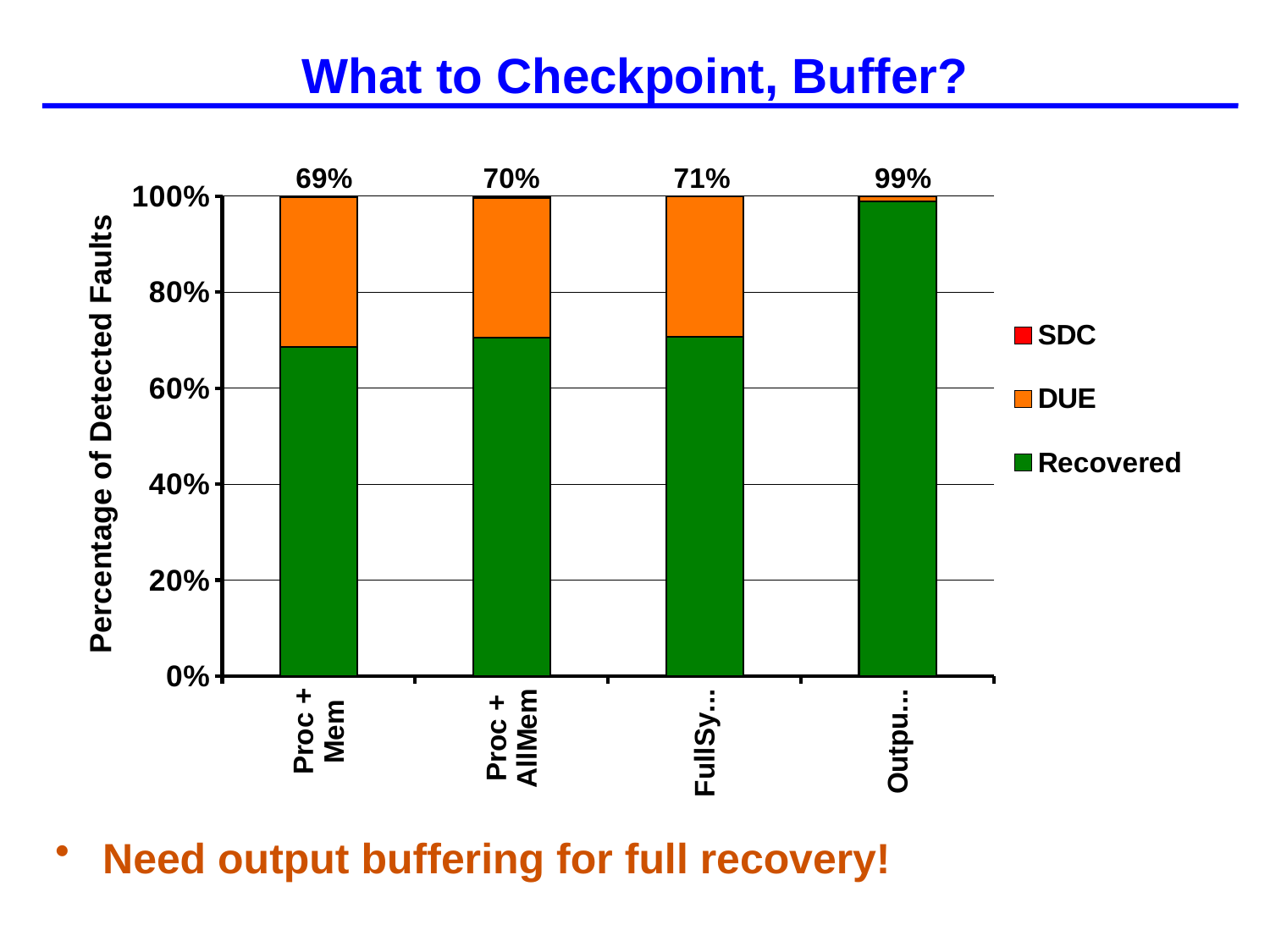
Which has the larger labelled value, Proc + Mem or Proc + AllMem? Proc + AllMem Do the labelled values rise or fall from left to right across the bars? rise How many bars (categories) are shown in the chart? 4 What is the labelled value above the rightmost bar? 99% What is the difference between the labelled values of Proc + AllMem and Proc + Mem? 1% What is the labelled value above the Proc + Mem bar? 69% What kind of chart is shown on the slide? stacked bar chart What is the labelled value above the third bar from the left? 71% How many series does the legend list? 3 Which bar has the lowest labelled value? Proc + Mem Is the DUE portion of the Proc + Mem bar greater or less than 20%? greater What is the labelled value above the Proc + AllMem bar? 70%